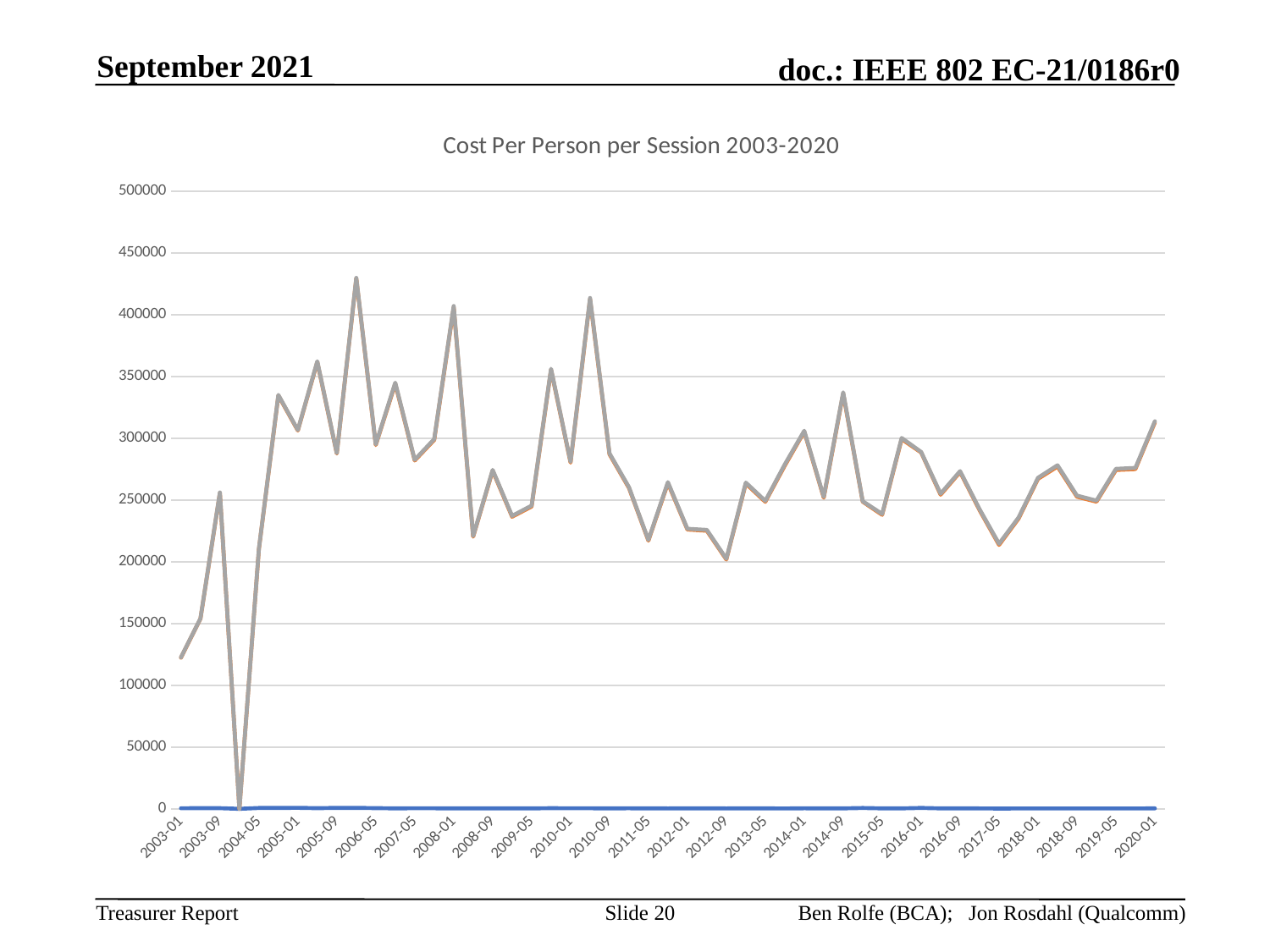
Which is larger, the value for 2003-01 or the value for 2003-09? 2003-09 Is the value for 2003-09 greater or less than 200000? greater Is the value for 2020-01 greater or less than 300000? greater Does the line rise or fall between 2003-01 and 2003-09? rise What is the highest value shown on the vertical axis of the chart? 500000 Which is larger, the value for 2003-01 or the value for 2020-01? 2020-01 What is the title of the chart? Cost Per Person per Session 2003-2020 Is the value for 2003-01 greater or less than 100000? greater What kind of chart is shown on the slide? line chart